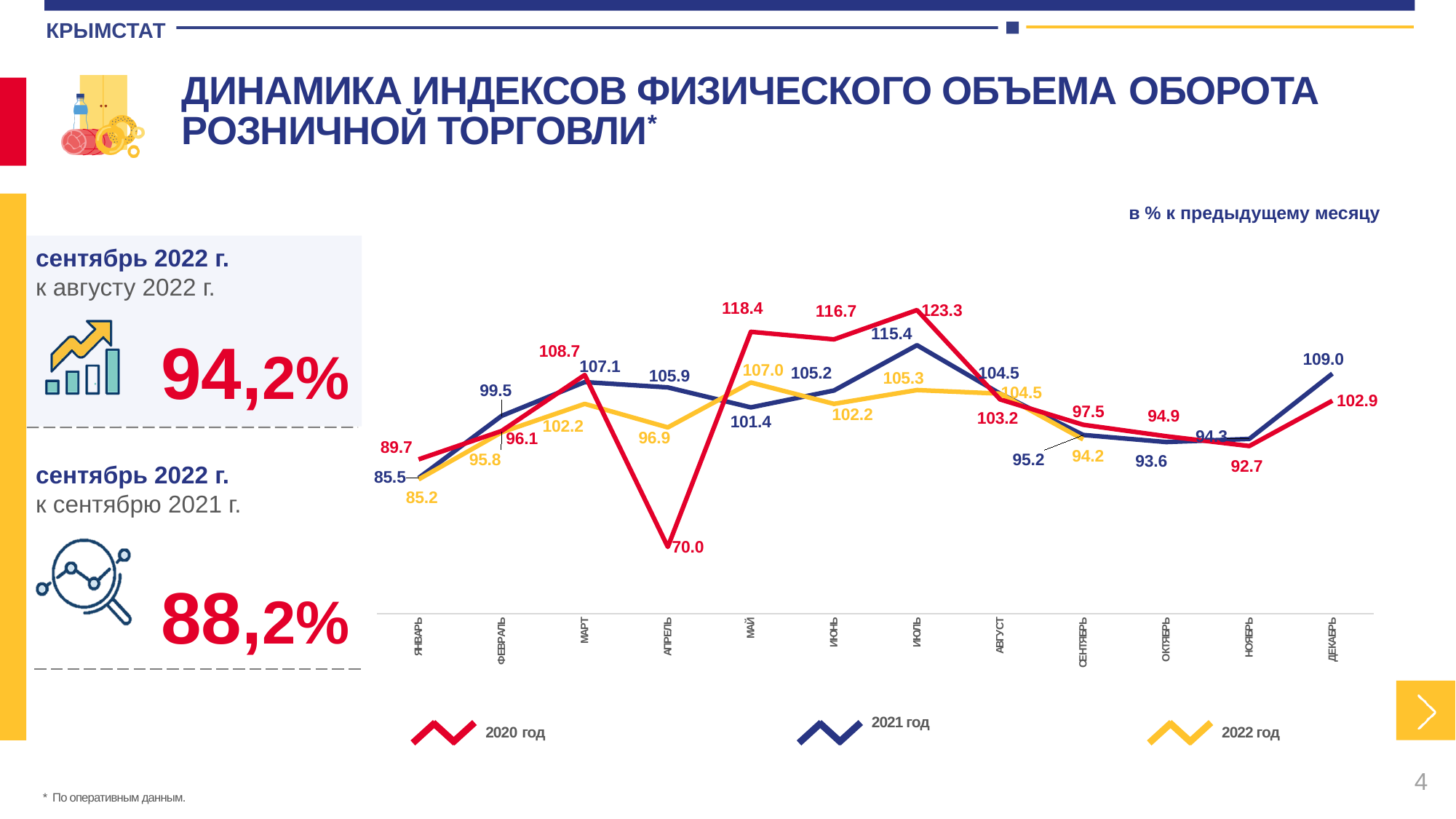
Which colour is used for the 2022 год series? yellow How many months are shown on the x axis? 12 What is the difference between the 2020 год and 2021 год values in июль? 7.9 In which month does the 2020 год series reach its highest value? июль Does the 2021 год series rise or fall from ноябрь to декабрь? rise How many series does the legend list? 3 In which month does the 2020 год series have its lowest value? апрель Which is larger in сентябрь: the value for 2020 год or for 2021 год? 2020 год What is the value for 2022 год in май? 107.0 What kind of chart is shown on the slide? line chart What is the value for 2021 год in декабрь? 109.0 What is the value for 2020 год in апрель? 70.0